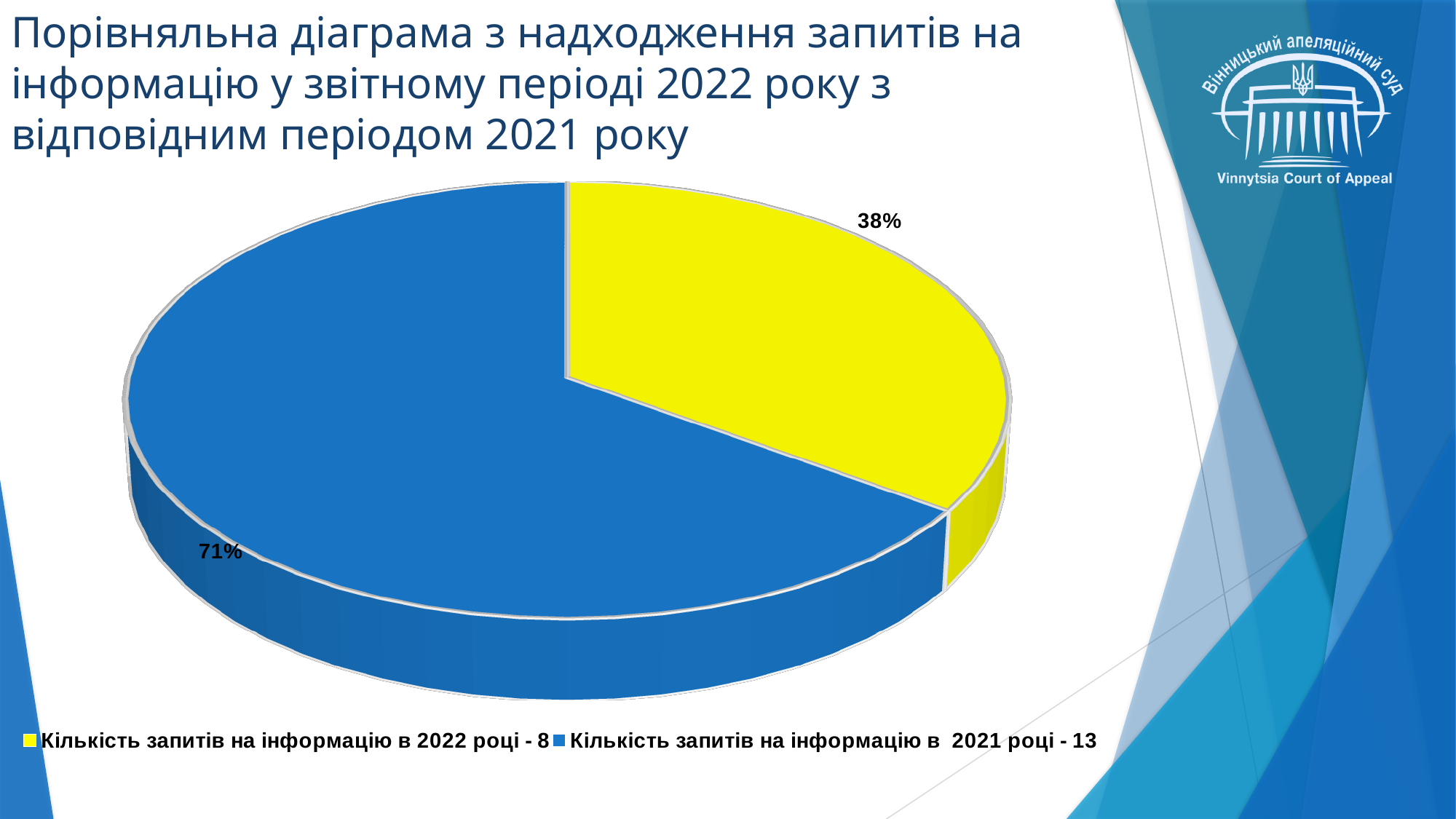
What percentage is shown for the yellow slice (Кількість запитів на інформацію в 2022 році)? 38% What percentage is shown for the blue slice (Кількість запитів на інформацію в 2021 році)? 71% Which slice is the smallest in the pie chart? Кількість запитів на інформацію в 2022 році - 8 According to the legend, how many information requests were received in 2022? 8 What kind of chart is shown on the slide? pie chart What is the difference between the number of information requests in 2021 and in 2022? 5 How many slices does the pie chart have? 2 Which year had more information requests, 2021 or 2022? 2021 What colour is the slice for information requests in 2022? yellow According to the legend, how many information requests were received in 2021? 13 How many entries does the legend list? 2 Which slice is the largest in the pie chart? Кількість запитів на інформацію в 2021 році - 13